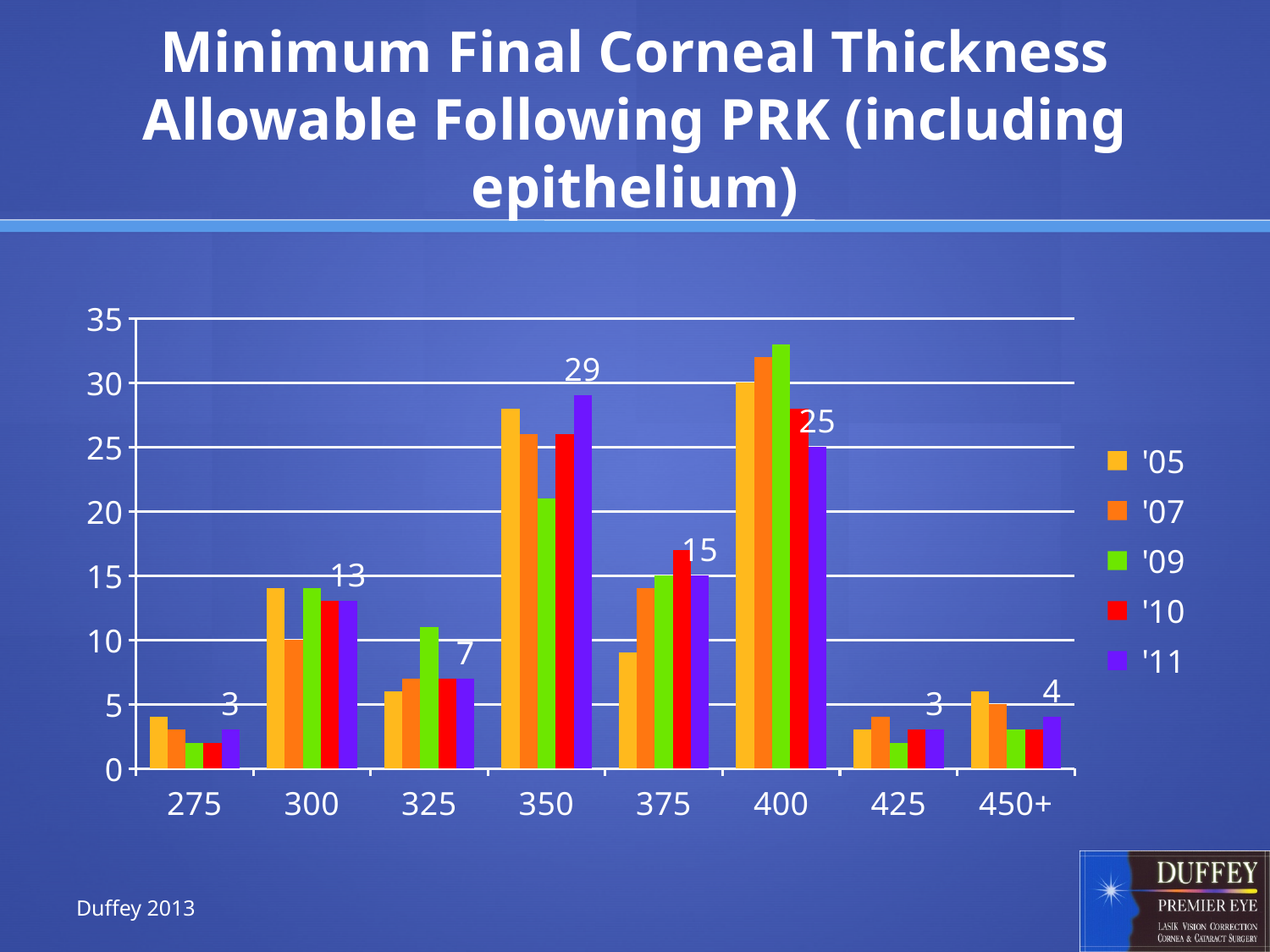
What is the value for the '11 series at 350? 29 What is the value for the '11 series at 300? 13 What is the difference between the '11 values at 350 and 400? 4 What type of chart is shown on the slide? Bar chart How many categories are shown on the x axis? 8 Which is larger for the '11 series: the value at 375 or the value at 300? 375 What is the value for the '11 series at 450+? 4 How many series does the legend list? 5 Is the value for the '05 series at 375 greater or less than 10? less Is the value for the '09 series at 400 greater or less than 30? greater Among the labelled '11 values, which category has the highest value? 350 What is the value for the '11 series at 400? 25